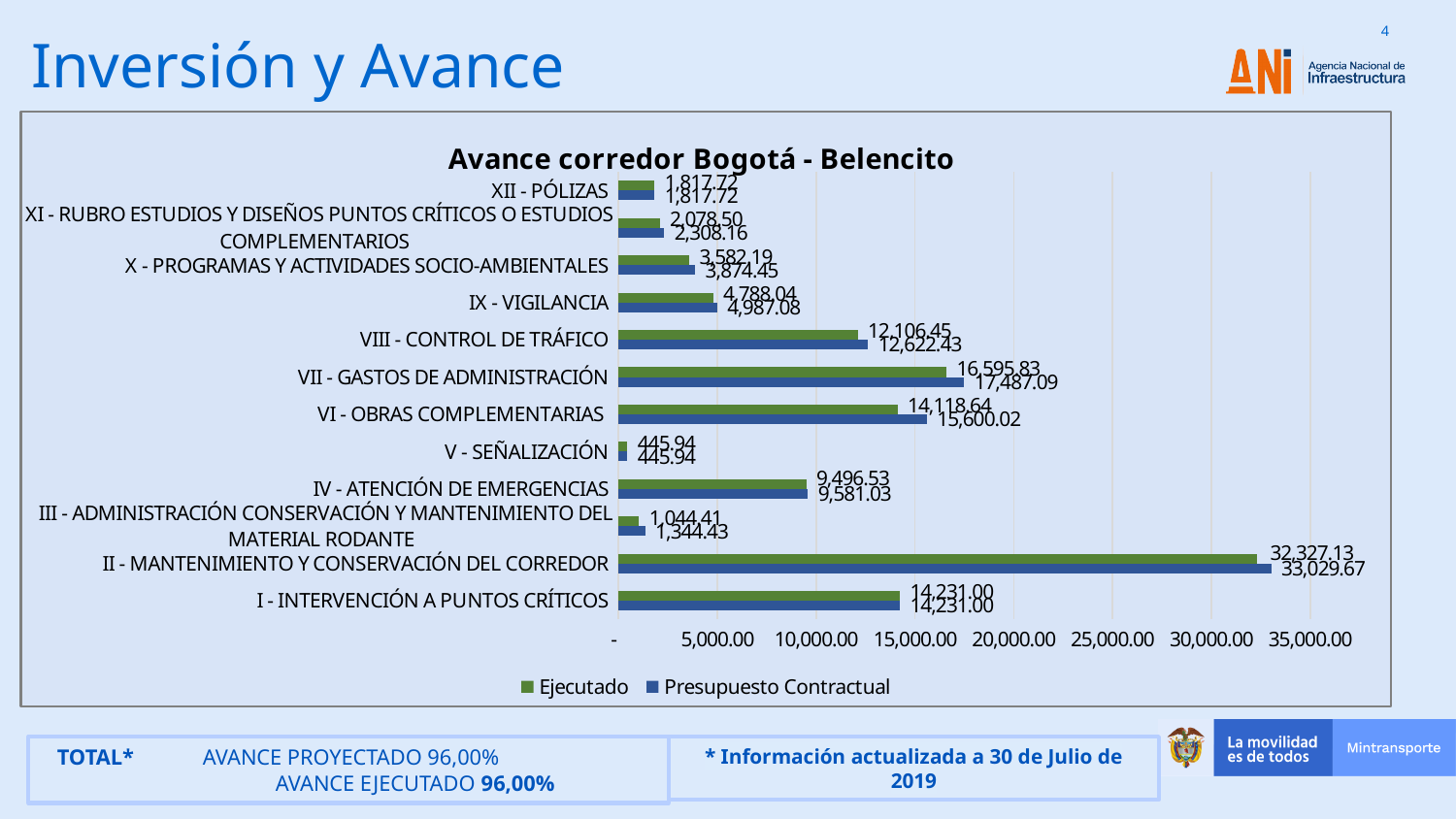
What is the Ejecutado value for VII - GASTOS DE ADMINISTRACIÓN? 16,595.83 What is the Ejecutado value for IV - ATENCIÓN DE EMERGENCIAS? 9,496.53 What is the difference between the Presupuesto Contractual and Ejecutado values for VI - OBRAS COMPLEMENTARIAS? 1,481.38 Which category has the highest Presupuesto Contractual value? II - MANTENIMIENTO Y CONSERVACIÓN DEL CORREDOR What kind of chart is shown on the slide? bar chart How many series does the legend of the chart list? 2 Which category has the lowest Ejecutado value? V - SEÑALIZACIÓN What is the Presupuesto Contractual value for II - MANTENIMIENTO Y CONSERVACIÓN DEL CORREDOR? 33,029.67 Which has the larger Ejecutado value: VII - GASTOS DE ADMINISTRACIÓN or VI - OBRAS COMPLEMENTARIAS? VII - GASTOS DE ADMINISTRACIÓN How many categories are plotted in the chart? 12 Is the Presupuesto Contractual value for VIII - CONTROL DE TRÁFICO greater or less than 10,000.00? greater What is the title of the chart? Avance corredor Bogotá - Belencito